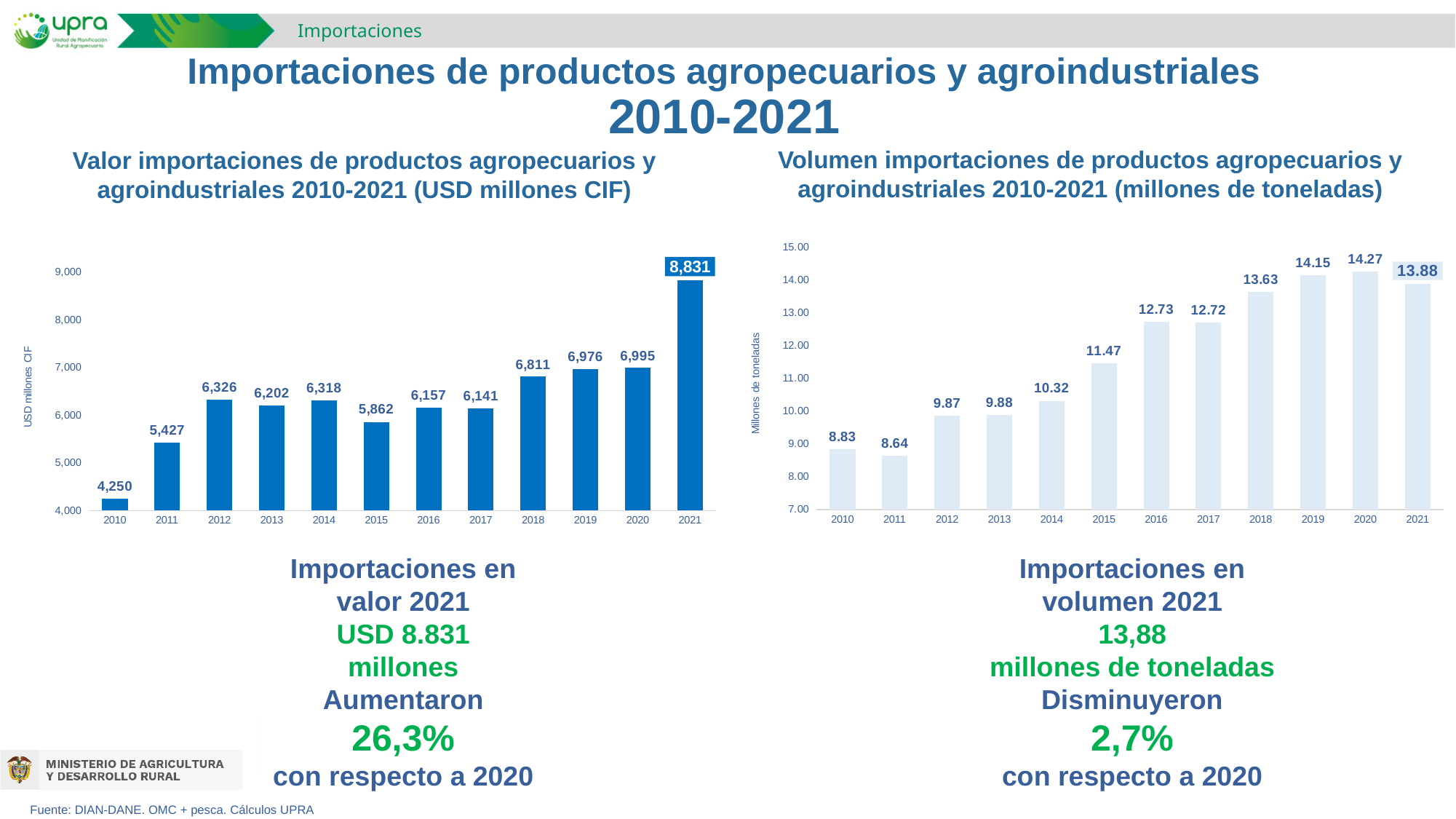
In the right chart (Volumen importaciones, millones de toneladas), is the value for 2018 greater or less than 13.00? greater In the right chart (Volumen importaciones, millones de toneladas), what is the value for 2015? 11.47 In the right chart (Volumen importaciones, millones de toneladas), what is the difference between the 2020 value and the 2021 value? 0.39 In the left chart (Valor importaciones, USD millones CIF), what is the difference between the 2021 value and the 2020 value? 1,836 In the left chart (Valor importaciones, USD millones CIF), which year has the highest value? 2021 In the left chart (Valor importaciones, USD millones CIF), how many years are plotted? 12 In the left chart (Valor importaciones, USD millones CIF), which is larger, the value for 2012 or the value for 2013? 2012 What is the y-axis label of the right chart (Volumen importaciones)? Millones de toneladas What kind of chart is the left chart (Valor importaciones, USD millones CIF)? Bar chart In the left chart (Valor importaciones, USD millones CIF), what is the value for 2010? 4,250 In the right chart (Volumen importaciones, millones de toneladas), which year has the highest value? 2020 In the right chart (Volumen importaciones, millones de toneladas), which year has the lowest value? 2011